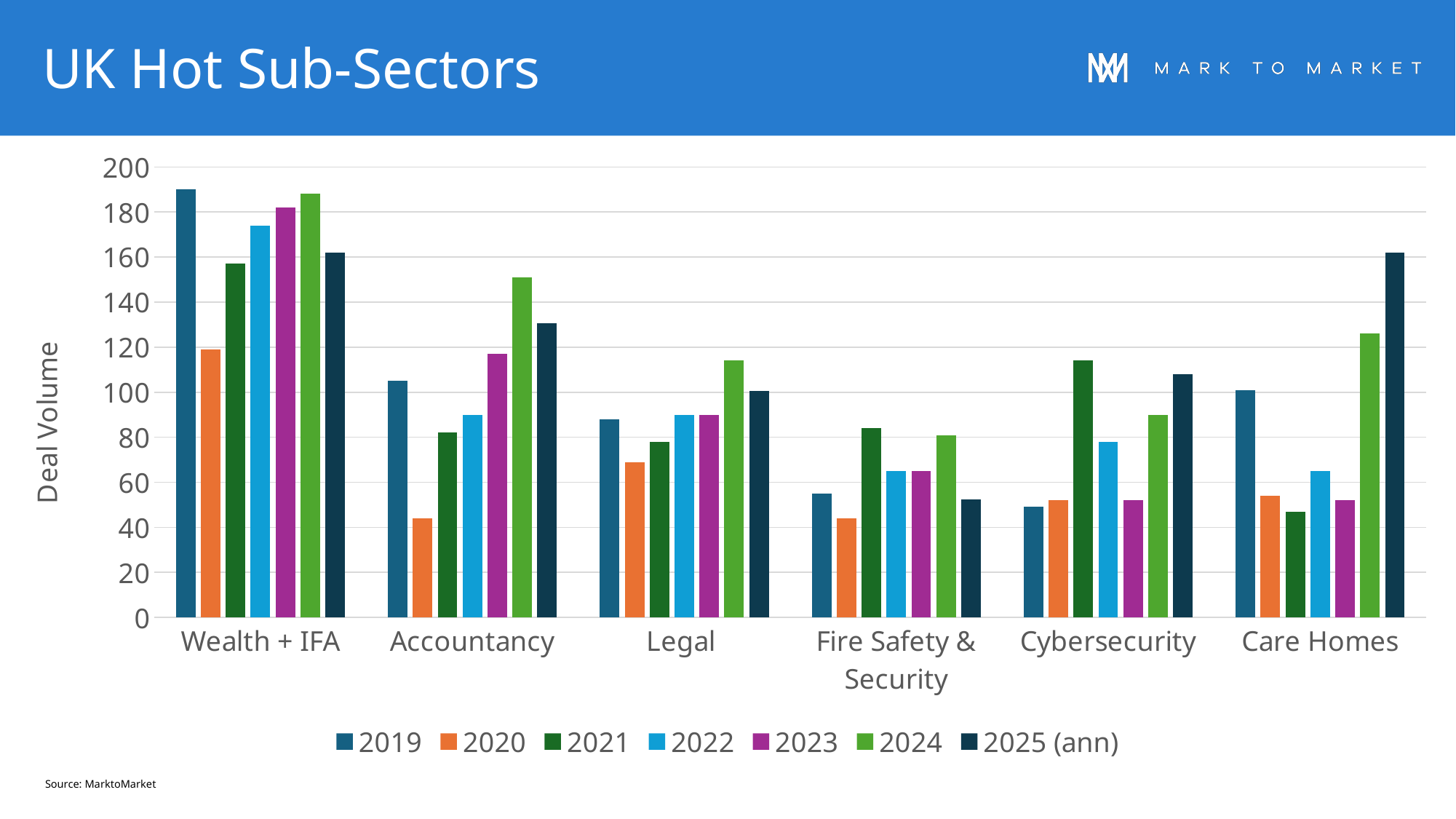
What type of chart is shown on the slide? bar chart How many sub-sectors are shown on the x axis? 6 Which sub-sector has the highest 2024 deal volume? Wealth + IFA For Care Homes, which is larger: the 2024 value or the 2025 (ann) value? 2025 (ann) How many series does the legend list? 7 Which has the larger 2024 deal volume: Legal or Fire Safety & Security? Legal Within Accountancy, which year has the highest deal volume? 2024 Within Wealth + IFA, which year has the lowest deal volume? 2020 Is the 2019 value for Cybersecurity greater or less than 60? less What is the label on the vertical axis? Deal Volume Is the 2024 value for Accountancy greater or less than 140? greater Is the 2019 value for Wealth + IFA greater or less than 180? greater